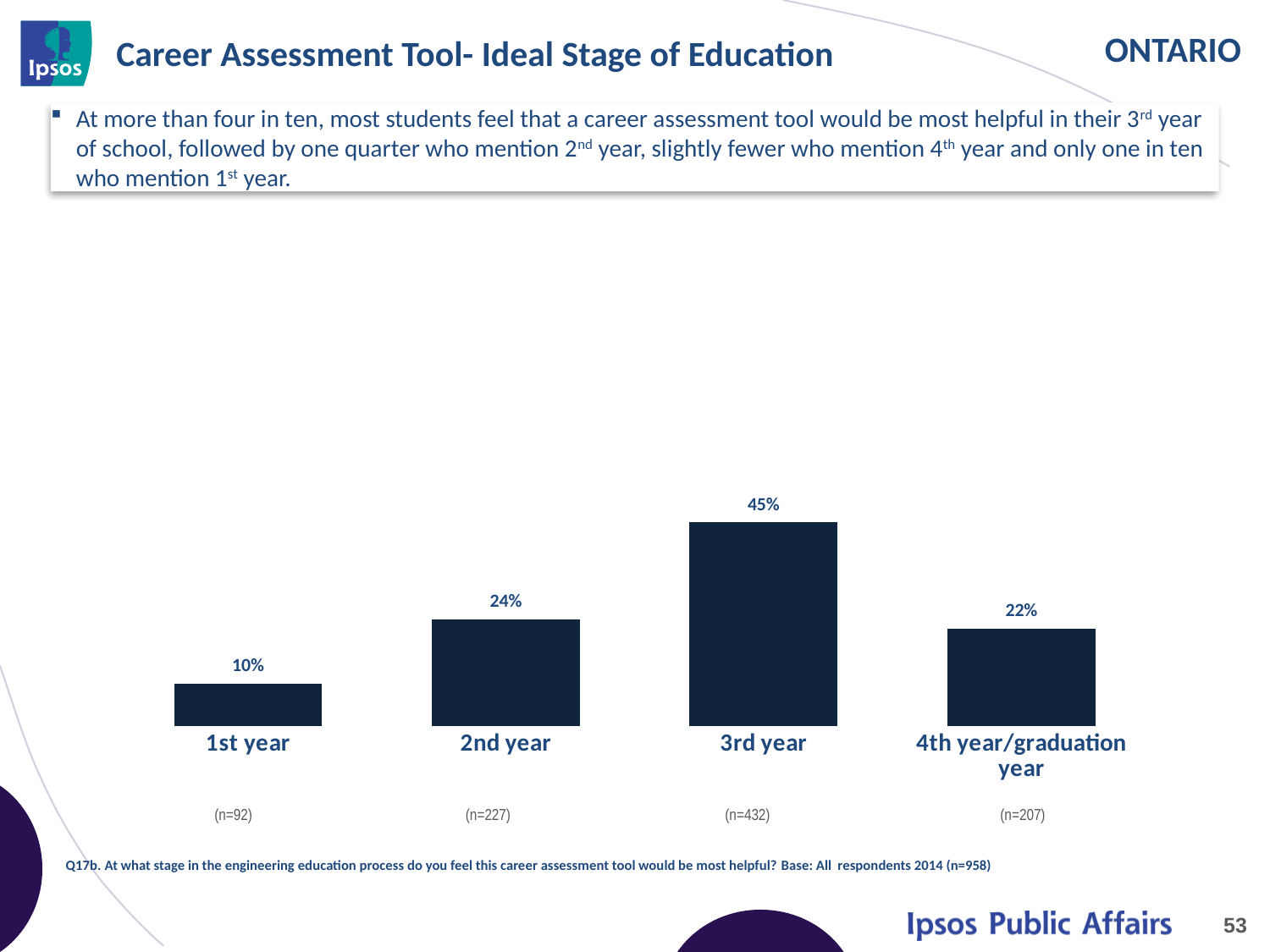
What is the difference between the values for 2nd year and 4th year/graduation year? 2% What is the difference between the values for 3rd year and 2nd year? 21% What is the value shown for 1st year? 10% What is the sample size (n) shown for 3rd year? n=432 How many stages of education are shown in the chart? 4 What is the value shown for 2nd year? 24% What is the value shown for 4th year/graduation year? 22% Which stage of education has the lowest value? 1st year What kind of chart is shown on the slide? Bar chart Which stage of education has the highest value? 3rd year Which has a larger value, 2nd year or 4th year/graduation year? 2nd year What percentage of students said a career assessment tool would be most helpful in their 3rd year? 45%